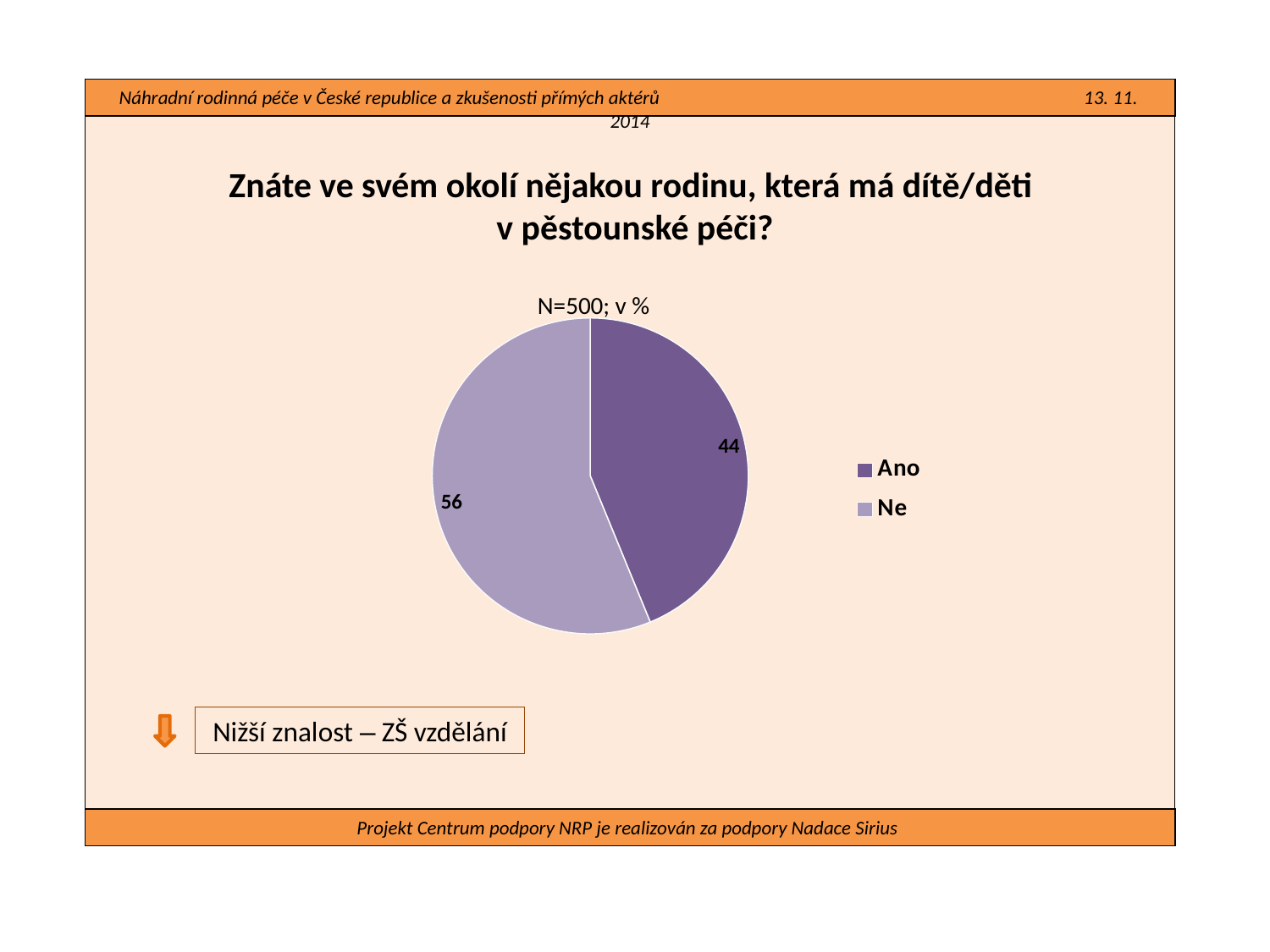
How many slices does the pie chart have? 2 Which is larger in the pie chart, "Ano" or "Ne"? Ne Which slice of the pie chart is the smallest? Ano What kind of chart is shown on the slide? Pie chart What value is shown for the "Ano" slice of the pie chart? 44 What share of the pie does the "Ano" slice represent? 44% What value is shown for the "Ne" slice of the pie chart? 56 Which legend entry is shown in the darker purple colour? Ano Which slice of the pie chart is the largest? Ne How many entries does the legend of the pie chart list? 2 What is the difference between the "Ne" and "Ano" values in the pie chart? 12 What is the chart's subtitle indicating the sample size and unit? N=500; v %